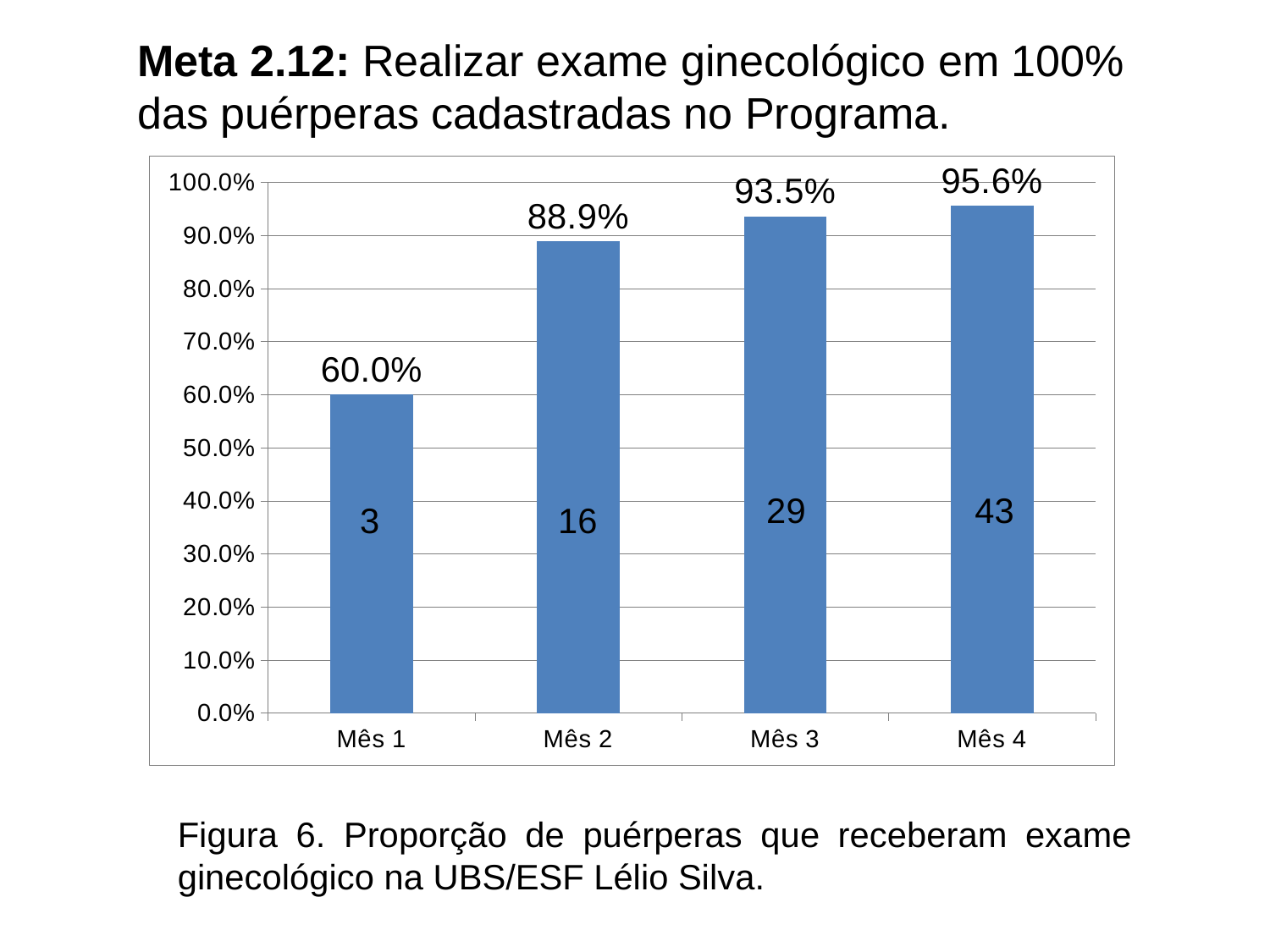
What number is printed inside the bar for Mês 2? 16 Which month has the lowest percentage? Mês 1 What kind of chart is shown on the slide? bar chart What is the percentage value shown for Mês 3? 93.5% How many months are shown on the x axis? 4 What is the percentage value shown for Mês 1? 60.0% What number is printed inside the bar for Mês 4? 43 What is the difference in percentage points between Mês 2 and Mês 1? 28.9 Do the percentages rise or fall from Mês 1 to Mês 4? rise Which month has the highest percentage? Mês 4 Is the value for Mês 1 greater or less than 70.0%? less Which is larger, the percentage for Mês 2 or for Mês 3? Mês 3